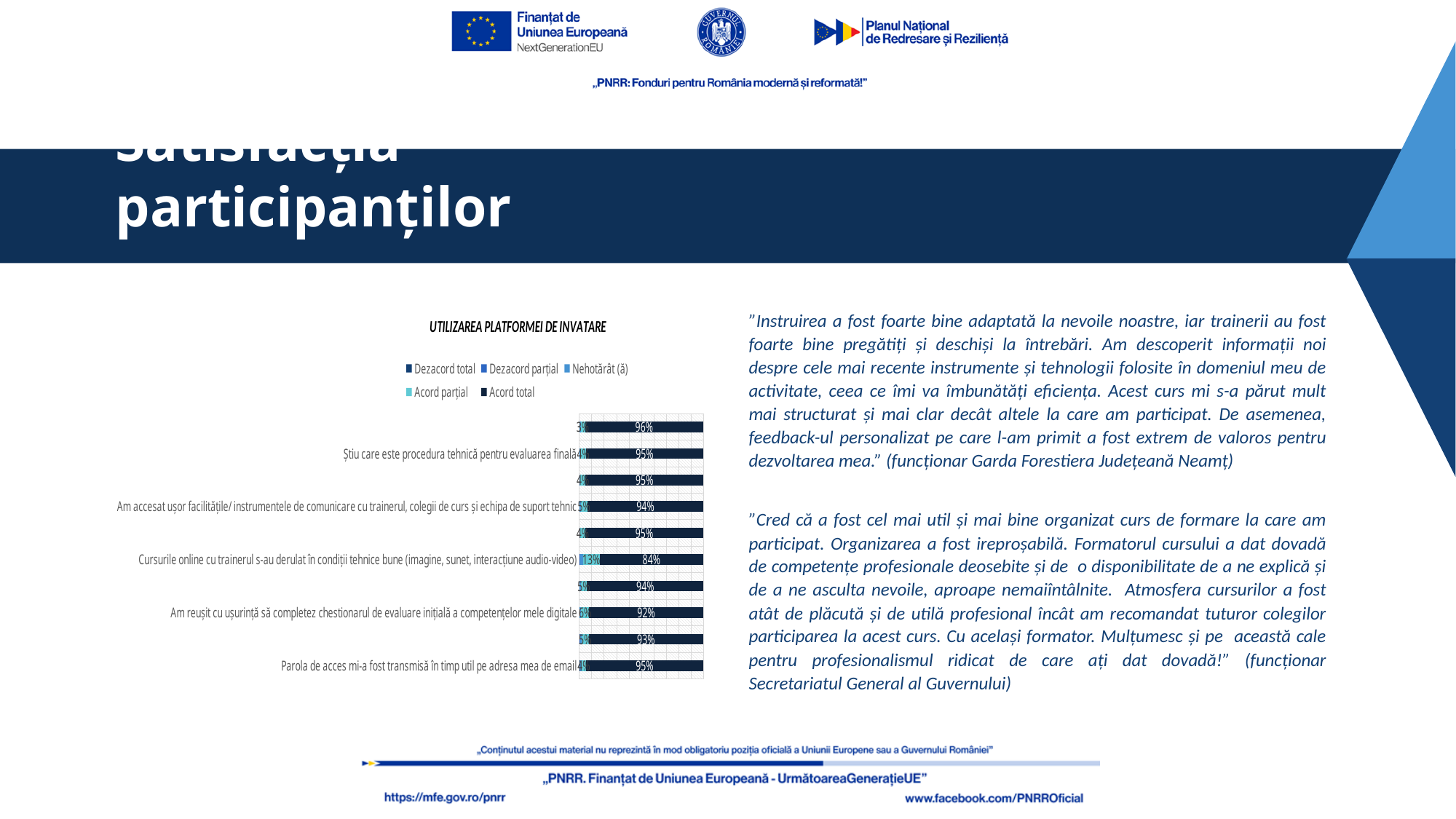
What is the Acord total value for "Cursurile online cu trainerul s-au derulat în condiții tehnice bune"? 84% What is the Acord total value for "Parola de acces mi-a fost transmisă în timp util pe adresa mea de email"? 95% What is the last series listed in the chart legend? Acord total What is the Acord parțial value for "Cursurile online cu trainerul s-au derulat în condiții tehnice bune"? 13% What is the Acord total value for "Am reușit cu ușurință să completez chestionarul de evaluare inițială a competențelor mele digitale"? 92% What is the difference in Acord total between "Parola de acces mi-a fost transmisă în timp util pe adresa mea de email" and "Cursurile online cu trainerul s-au derulat în condiții tehnice bune"? 11% What kind of chart is shown on the slide? bar chart How many bars are plotted in the chart? 10 Which has a higher Acord total value: "Știu care este procedura tehnică pentru evaluarea finală" or "Am reușit cu ușurință să completez chestionarul de evaluare inițială a competențelor mele digitale"? Știu care este procedura tehnică pentru evaluarea finală Which labelled statement has the lowest Acord total value? Cursurile online cu trainerul s-au derulat în condiții tehnice bune (imagine, sunet, interacțiune audio-video) How many series does the chart legend list? 5 What is the title of the chart? UTILIZAREA PLATFORMEI DE INVATARE